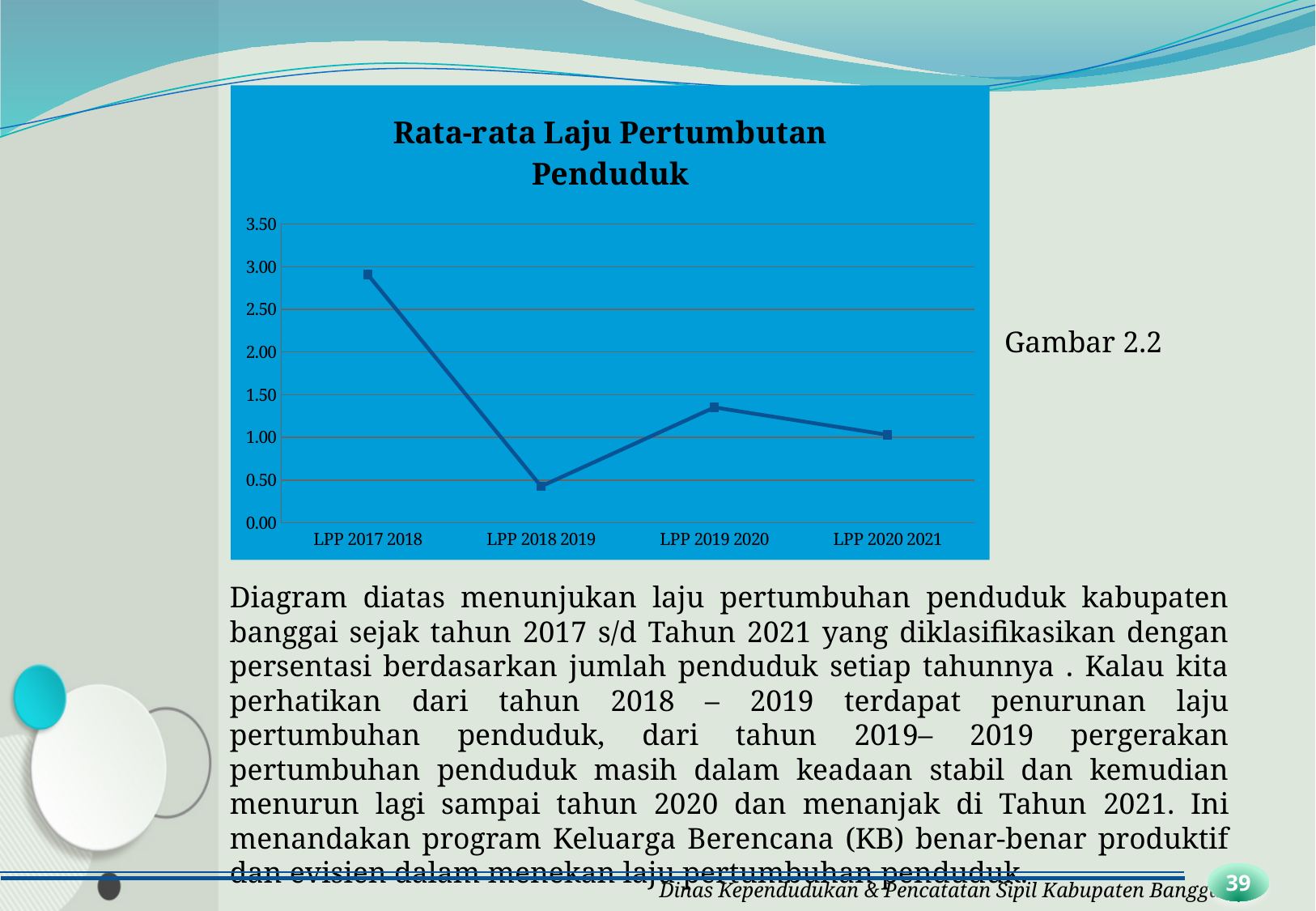
Does the value rise or fall from LPP 2017 2018 to LPP 2018 2019? fall What kind of chart is shown on the slide? line chart Which is larger, the value for LPP 2019 2020 or the value for LPP 2020 2021? LPP 2019 2020 Which category has the lowest value in the chart? LPP 2018 2019 Does the value rise or fall from LPP 2018 2019 to LPP 2019 2020? rise Is the value for LPP 2018 2019 greater or less than 1.00? less Is the value for LPP 2019 2020 greater or less than 1.00? greater How many categories are plotted along the x axis of the chart? 4 Is the value for LPP 2020 2021 greater or less than 1.50? less What is the title of the chart? Rata-rata Laju Pertumbutan Penduduk Which category has the highest value in the chart? LPP 2017 2018